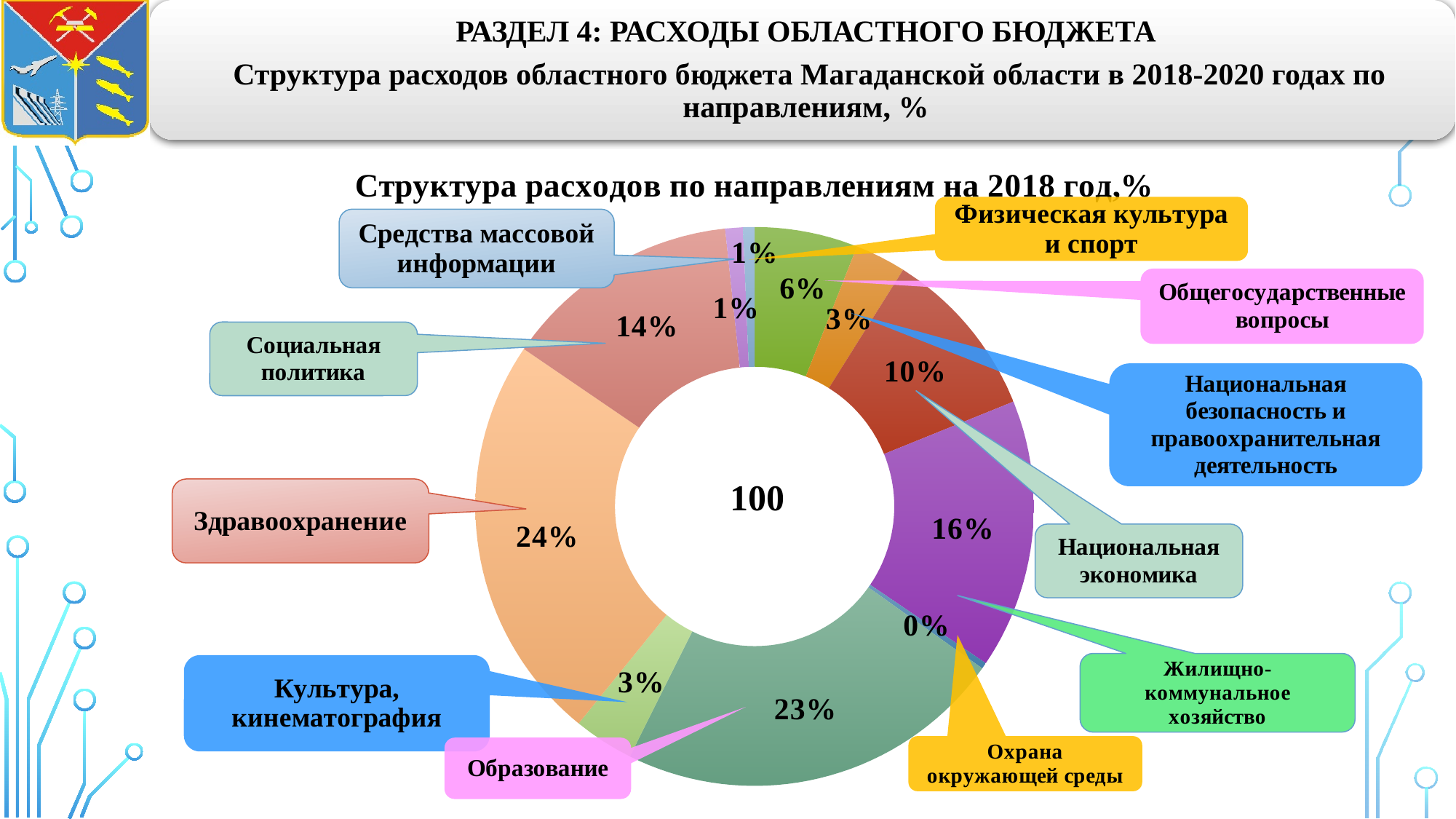
What share of expenditures goes to Образование? 23% What kind of chart is shown on the slide? Doughnut (pie) chart What is the difference in percentage points between Здравоохранение and Образование? 1 Which is larger, the share for Социальная политика or the share for Культура, кинематография? Социальная политика What is the title of the chart? Структура расходов по направлениям на 2018 год,% Which direction has the smallest share of expenditures? Охрана окружающей среды What share of expenditures goes to Социальная политика? 14% Which direction has the largest share of expenditures? Здравоохранение What share of expenditures goes to Охрана окружающей среды? 0% What share of expenditures goes to Культура, кинематография? 3% What number is shown in the centre of the doughnut chart? 100 What share of expenditures goes to Здравоохранение? 24%